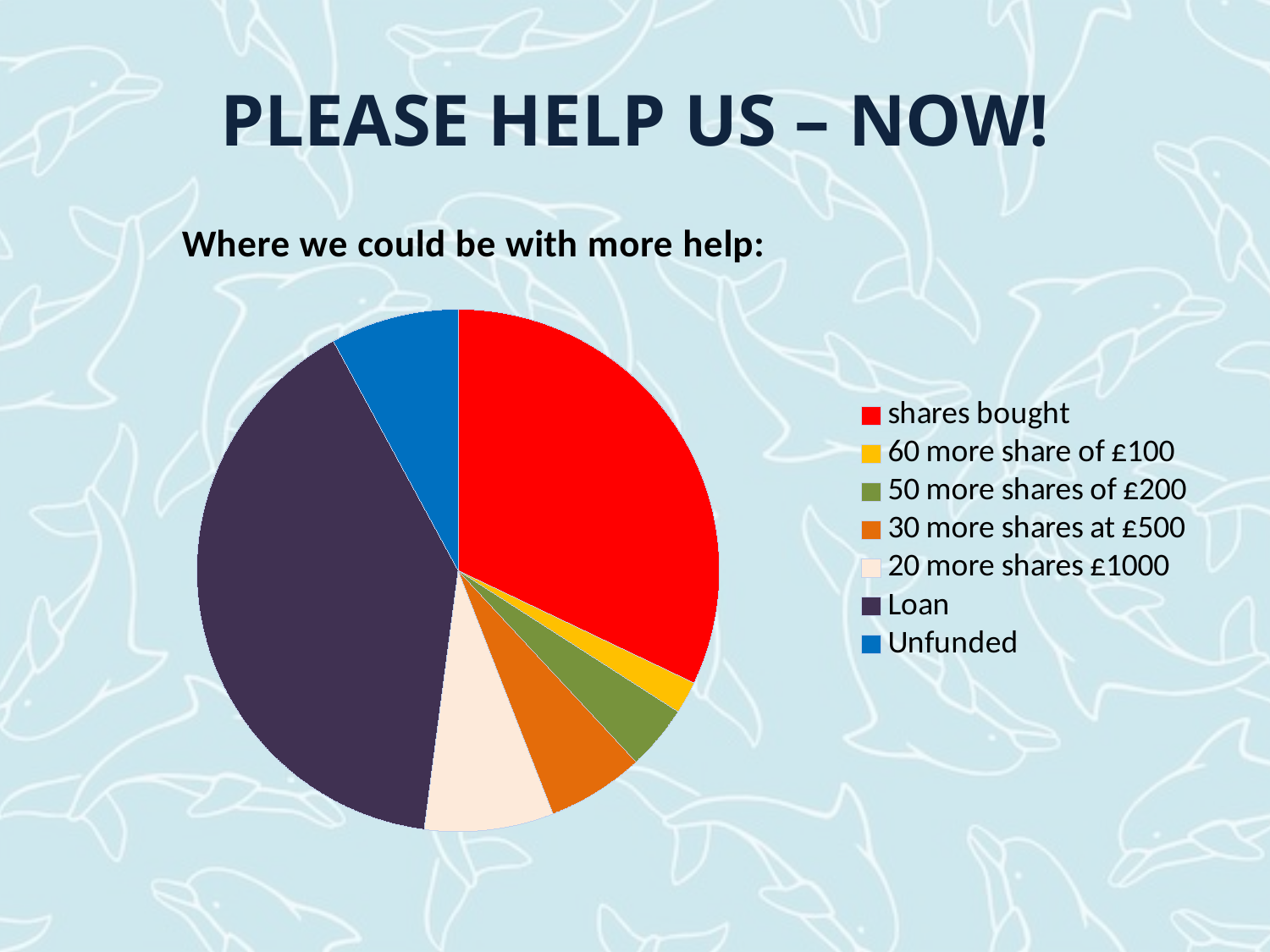
Which slice is larger: 20 more shares £1000 or 60 more share of £100? 20 more shares £1000 How many entries does the legend of the pie chart list? 7 What kind of chart is shown on the slide? pie chart Which slice is larger: 50 more shares of £200 or 60 more share of £100? 50 more shares of £200 Which slice is larger: Loan or 30 more shares at £500? Loan Which category has the smallest slice in the pie chart? 60 more share of £100 How many categories (slices) does the pie chart have? 7 Which category is shown in blue in the pie chart? Unfunded What colour is the slice for shares bought? red